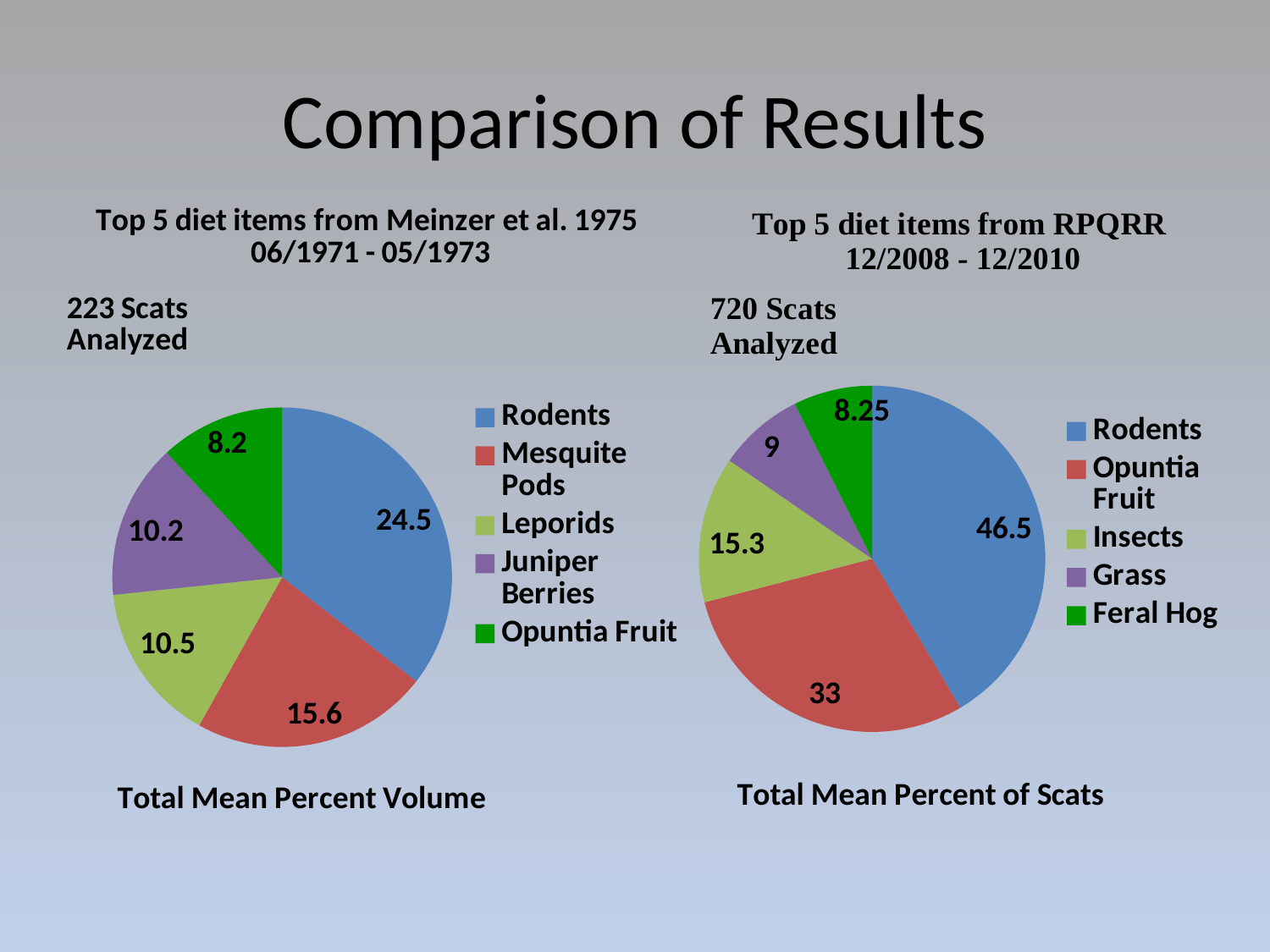
In the left pie chart (Meinzer et al. 1975), what is the difference between the values for Rodents and Mesquite Pods? 8.9 How many slices does the left pie chart (Meinzer et al. 1975) have? 5 In the left pie chart (Meinzer et al. 1975), which diet item has the smallest slice? Opuntia Fruit In the right pie chart (RPQRR), which diet item is shown in green in the legend? Feral Hog In the right pie chart (RPQRR), what is the value for Feral Hog? 8.25 In the left pie chart (Meinzer et al. 1975), what is the value for Mesquite Pods? 15.6 In the right pie chart (RPQRR), which diet item has the largest slice? Rodents In the right pie chart (RPQRR), which is larger, the value for Insects or the value for Grass? Insects In the left pie chart (Meinzer et al. 1975), what is the value for Rodents? 24.5 What kind of chart is used on the right side of the slide (RPQRR)? Pie chart In the right pie chart (RPQRR), what is the difference between the values for Rodents and Opuntia Fruit? 13.5 In the right pie chart (RPQRR), what is the value for Opuntia Fruit? 33